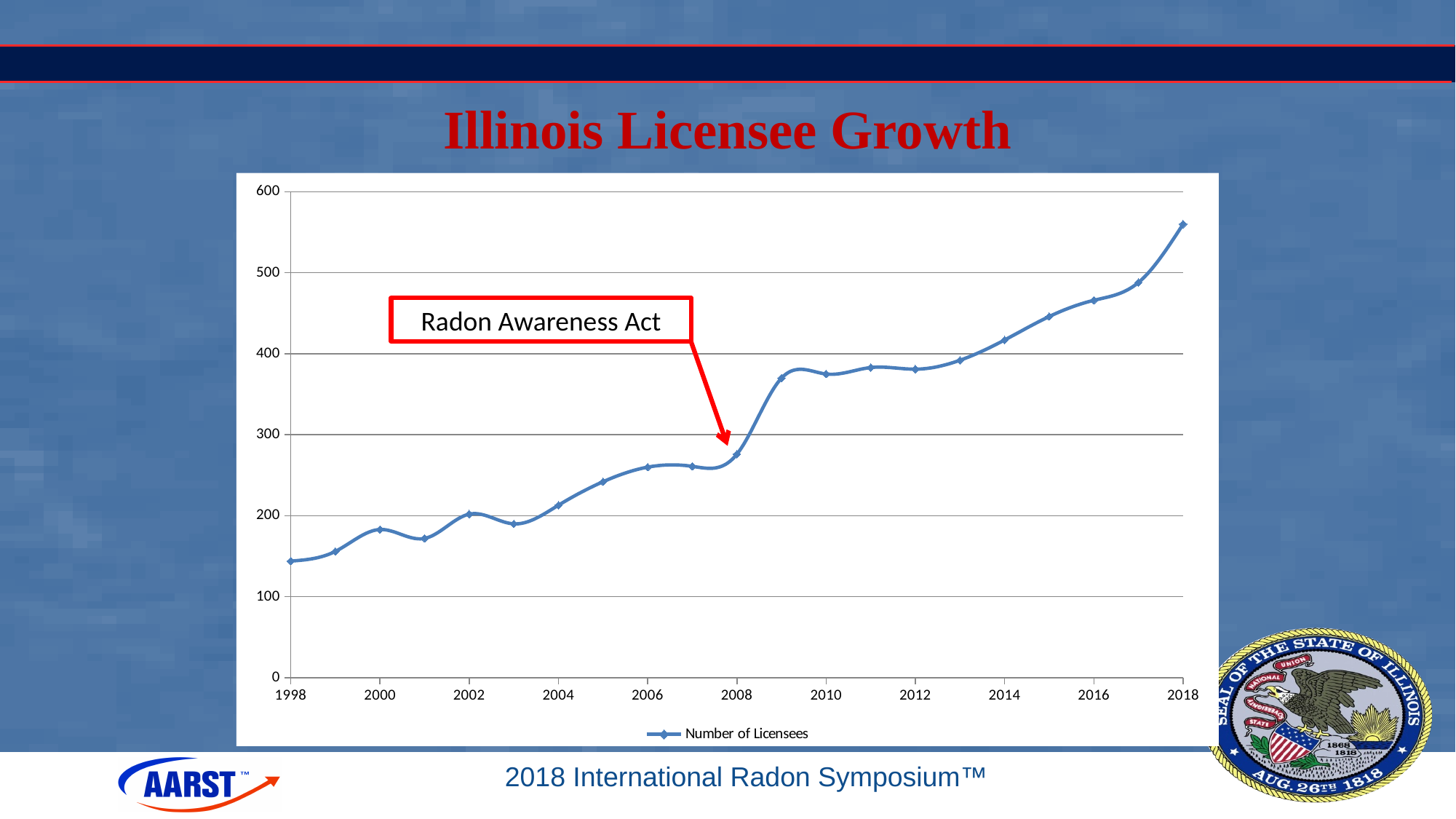
What series name appears in the legend? Number of Licensees Is the value for 2008 greater or less than 300? less Is the value for 2018 greater or less than 500? greater Is the value for 1998 greater or less than 200? less In which year is the number of licensees lowest? 1998 In which year is the number of licensees highest? 2018 Which year has a larger number of licensees, 2009 or 2007? 2009 What is the title of the chart? Illinois Licensee Growth How many series does the legend list? 1 What kind of chart is shown on the slide? Line chart Overall, do the values rise or fall from 1998 to 2018? rise